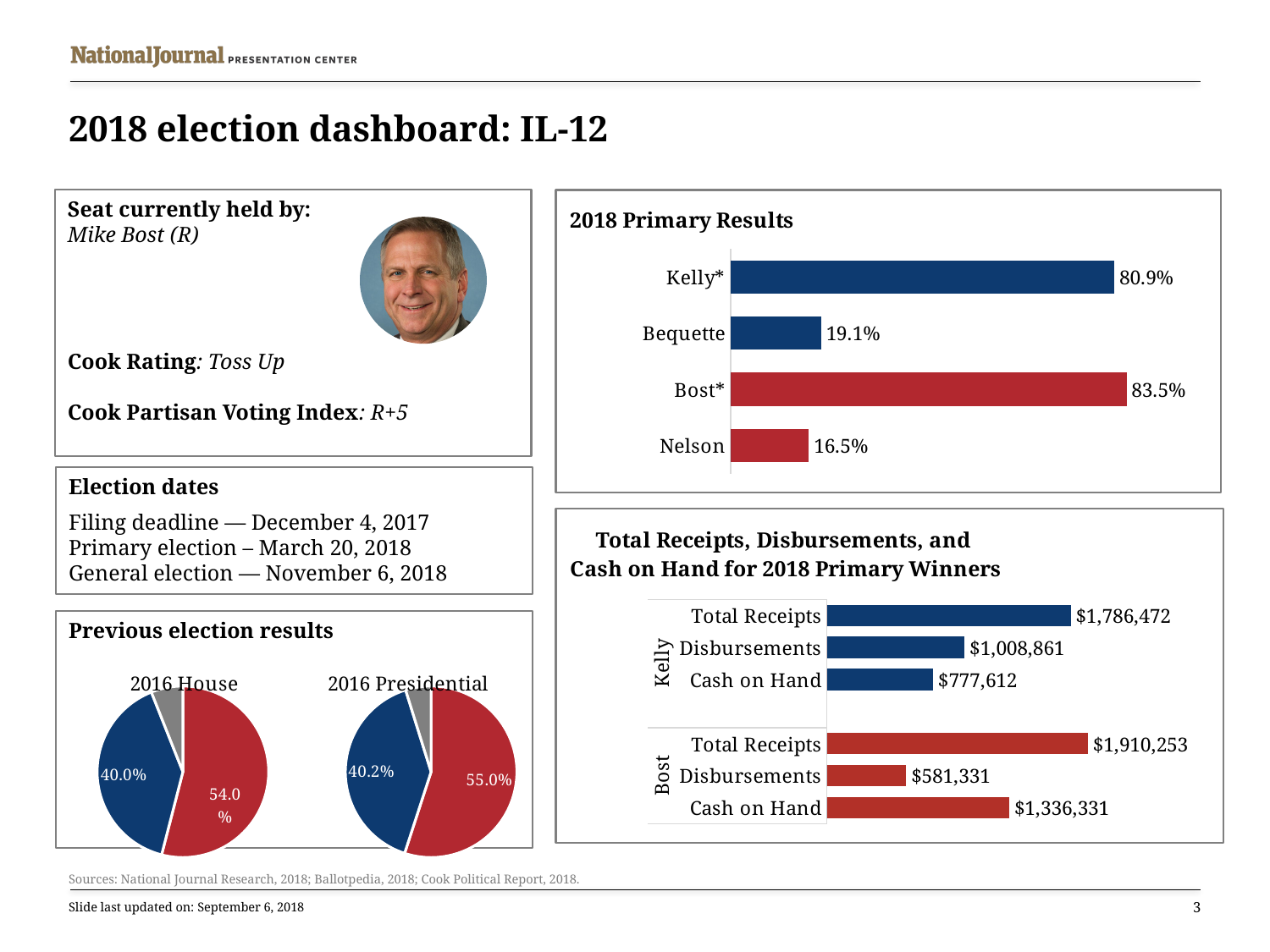
In the Total Receipts, Disbursements, and Cash on Hand chart, who has higher Disbursements, Kelly or Bost? Kelly In the 2016 Presidential pie chart under Previous election results, what share does the red slice represent? 55.0% In the Total Receipts, Disbursements, and Cash on Hand chart, what is Kelly's Cash on Hand? $777,612 In the Total Receipts, Disbursements, and Cash on Hand chart, what are Bost's Total Receipts? $1,910,253 In the 2018 Primary Results chart, what is the difference between Bost*'s and Nelson's percentages? 67.0 percentage points What type of chart is the 2018 Primary Results chart? Bar chart In the 2018 Primary Results chart, which candidate has the highest percentage? Bost* In the 2018 Primary Results chart, which candidate has the lowest percentage? Nelson In the 2018 Primary Results chart, what percentage did Kelly* receive? 80.9% In the 2018 Primary Results chart, what percentage did Nelson receive? 16.5% How many candidates are shown in the 2018 Primary Results chart? 4 In the Total Receipts, Disbursements, and Cash on Hand chart, what is the difference between Bost's and Kelly's Total Receipts? $123,781